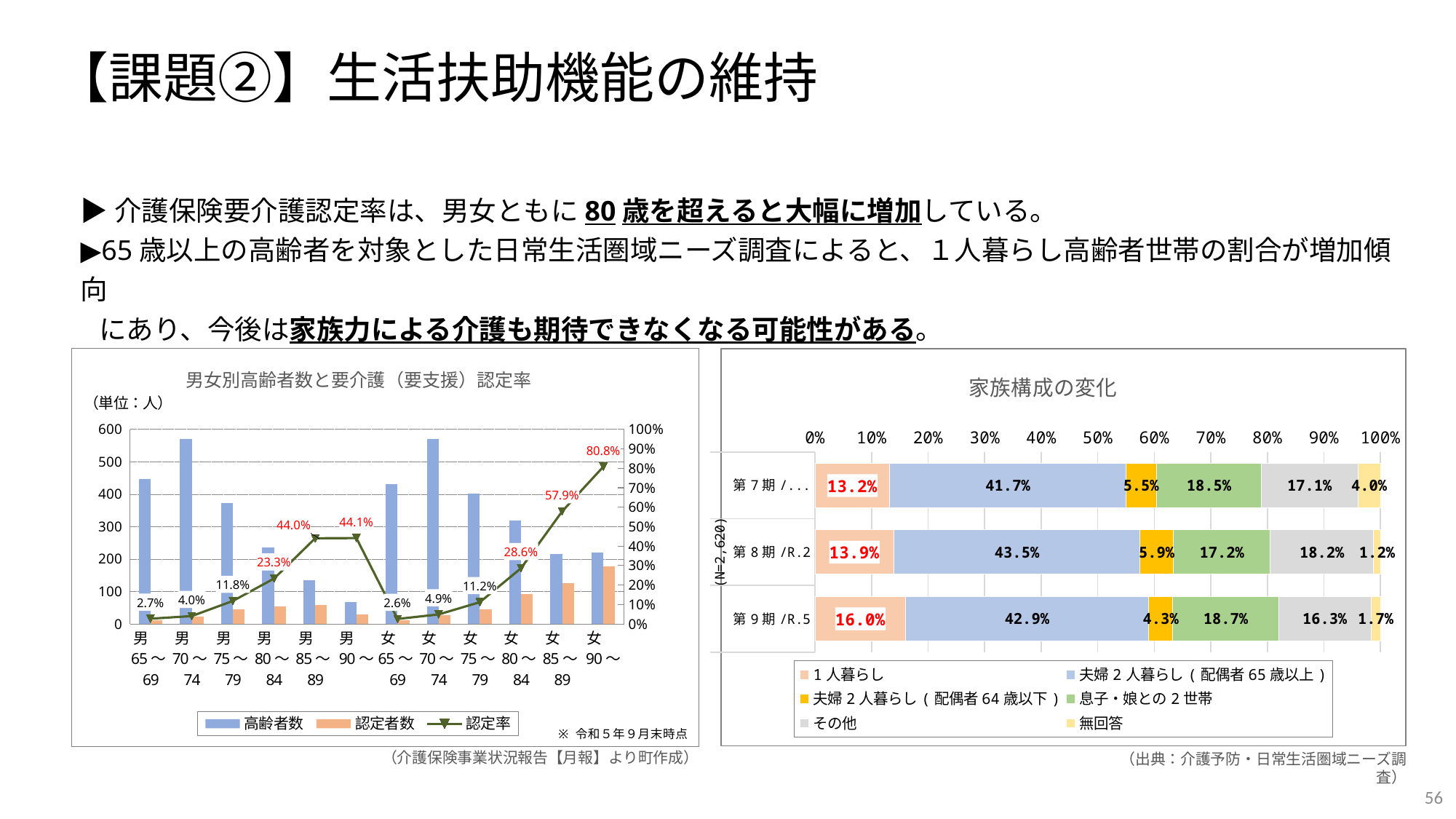
In the left chart (男女別高齢者数と要介護（要支援）認定率), is the 高齢者数 for 男 70～74 greater or less than 500? greater In the left chart (男女別高齢者数と要介護（要支援）認定率), what is the 認定率 for 男 80～84? 23.3% In the right chart (家族構成の変化), how many entries does the legend list? 6 In the right chart (家族構成の変化), what is the share of 1人暮らし for 第9期/R.5? 16.0% In the right chart (家族構成の変化), which period has the highest share of 1人暮らし? 第9期/R.5 In the left chart (男女別高齢者数と要介護（要支援）認定率), which category has the highest 認定率? 女 90～ In the left chart (男女別高齢者数と要介護（要支援）認定率), how many series does the legend list? 3 In the left chart (男女別高齢者数と要介護（要支援）認定率), how many age-sex categories are shown on the x axis? 12 In the right chart (家族構成の変化), what is the share of 夫婦2人暮らし（配偶者65歳以上） for 第8期/R.2? 43.5% In the left chart (男女別高齢者数と要介護（要支援）認定率), what is the difference between the 認定率 for 女 85～89 and 男 85～89? 13.9 percentage points In the right chart (家族構成の変化), which is larger, the 息子・娘との2世帯 share for 第7期 or for 第8期/R.2? 第7期 In the left chart (男女別高齢者数と要介護（要支援）認定率), what is the 認定率 for 女 90～? 80.8%